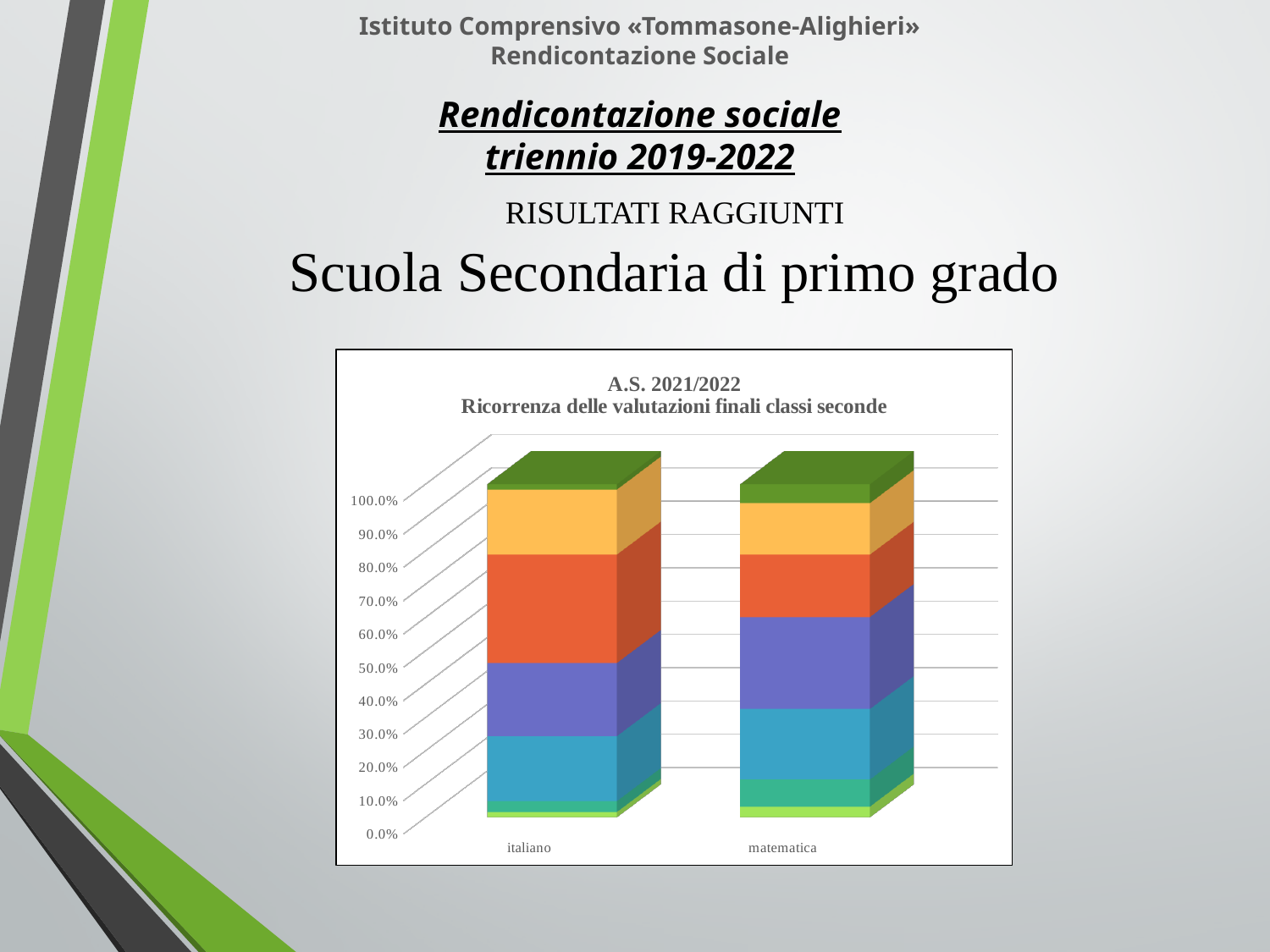
Which category has the larger orange segment, italiano or matematica? italiano Is the top of the orange segment for italiano greater or less than 70.0%? greater Does the chart include a legend identifying the stacked segments? No What is the title of the chart? A.S. 2021/2022 Ricorrenza delle valutazioni finali classi seconde Is the bottom of the orange segment for italiano greater or less than 60.0%? less Which category has the larger dark green segment at the top of its bar, italiano or matematica? matematica What is the total height of the stacked bar for matematica? 100.0% What is the total height of the stacked bar for italiano? 100.0% Is the bottom of the orange segment for matematica greater or less than 50.0%? greater How many categories are shown on the x axis of the chart? 2 What type of chart is shown on the slide? Stacked bar chart What are the two categories shown on the x axis of the chart? italiano and matematica